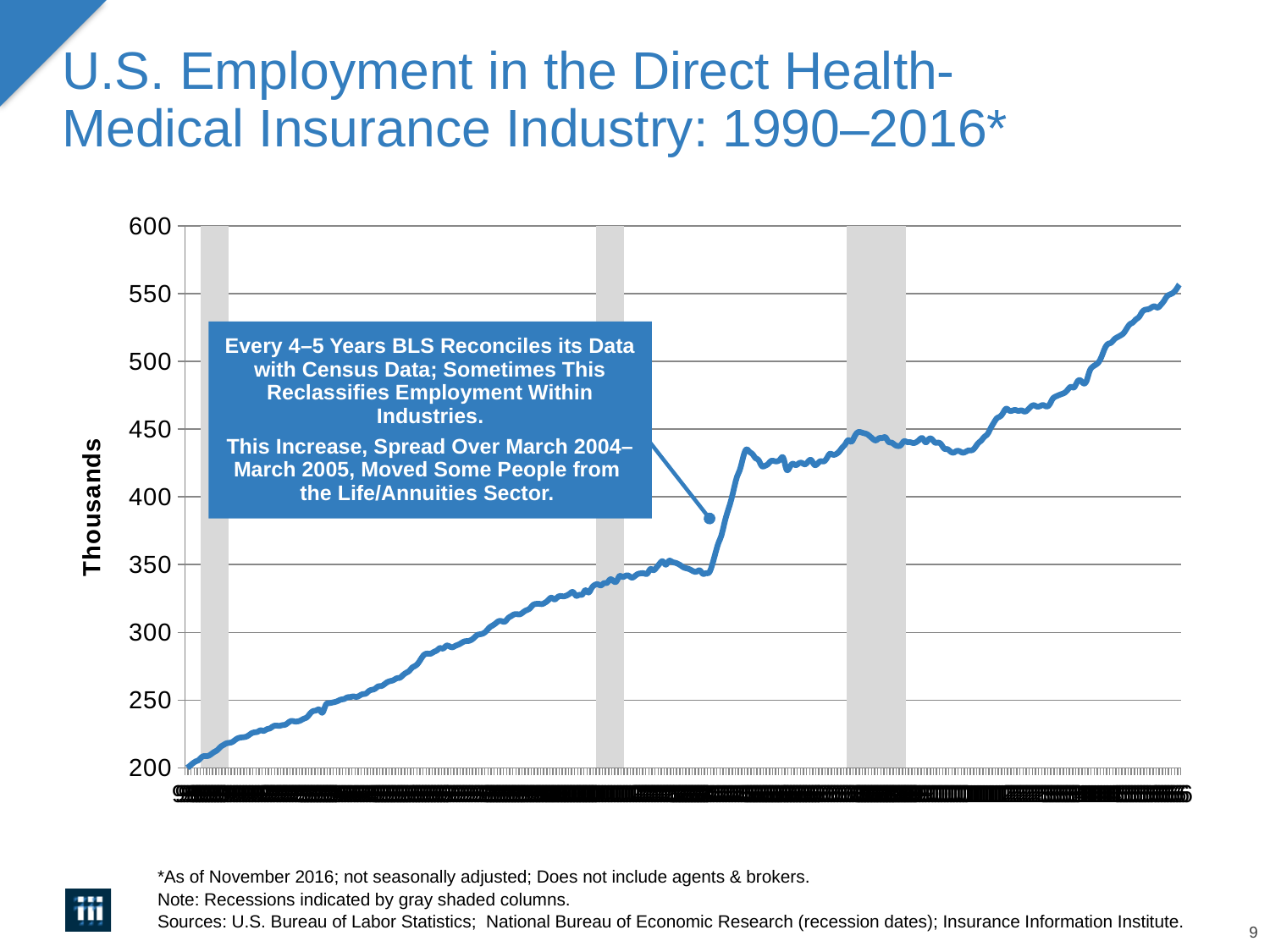
Is the value at the start of the series (1990) greater or less than 250? less Overall, do the values rise or fall from 1990 to 2016 along the x axis? rise Is the value at the end of the series (2016) greater or less than 400? greater How many gray shaded recession columns are shown on the chart? 3 What is the label on the vertical axis of the chart? Thousands What is the highest value shown on the vertical axis? 600 What is the title of the chart? U.S. Employment in the Direct Health-Medical Insurance Industry: 1990–2016* Is the value at the end of the series (2016) greater or less than 500? greater Which is larger, the value at the start of the series (1990) or the value at the end of the series (2016)? the end of the series (2016) What kind of chart is shown on the slide? line chart